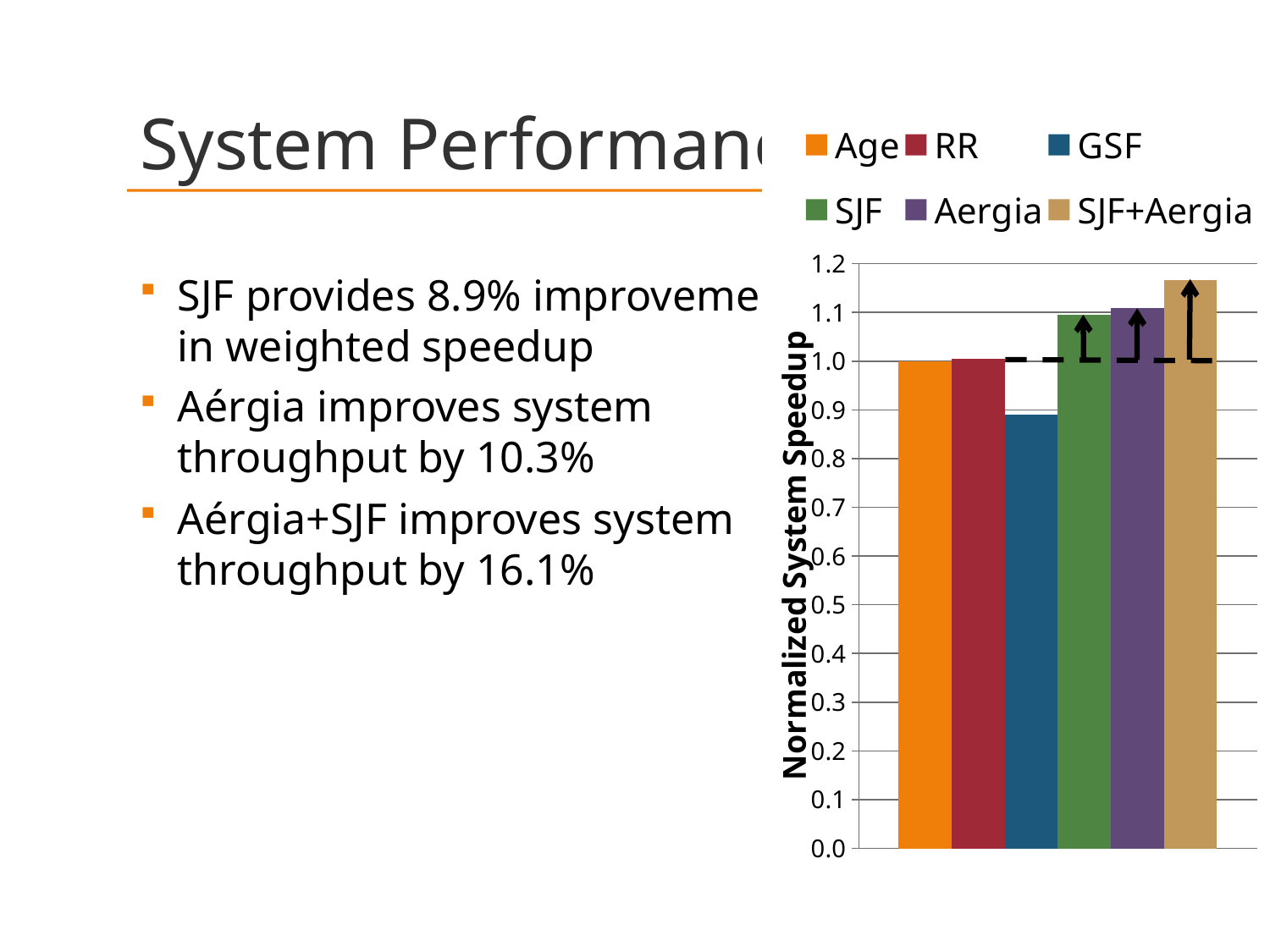
Is the value for GSF greater or less than 0.8? greater What colour is the GSF bar in the chart? blue Is the value for GSF greater or less than 1.0? less Which series has the lowest normalized system speedup? GSF What is the title of the chart's vertical axis? Normalized System Speedup Which is larger, the value for SJF or the value for GSF? SJF Which is larger, the value for SJF+Aergia or the value for Age? SJF+Aergia What kind of chart is shown on the slide? bar chart How many series does the chart legend list? 6 Which series has the highest normalized system speedup? SJF+Aergia Is the value for SJF+Aergia greater or less than 1.1? greater